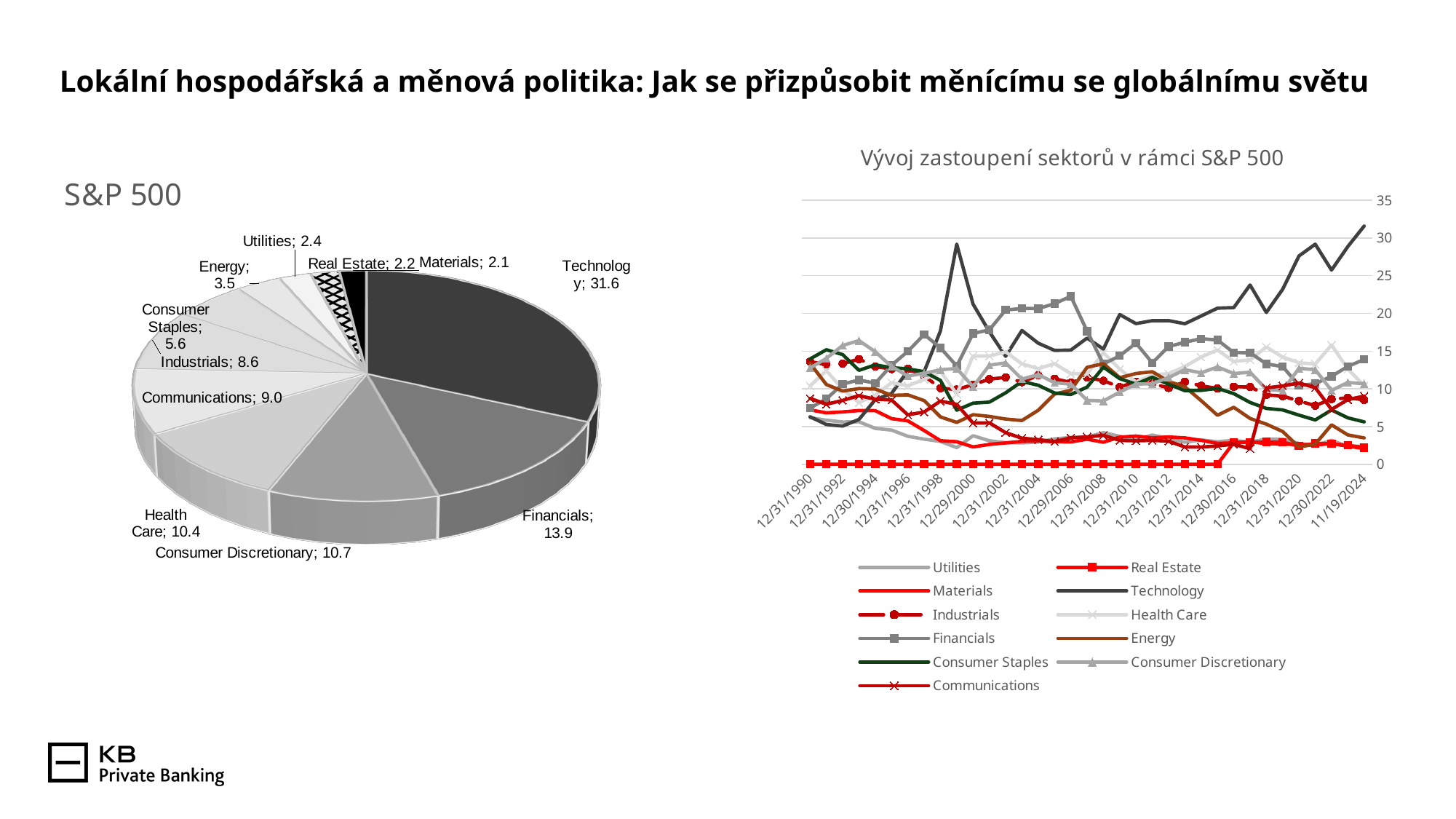
In the S&P 500 pie chart, which sector has the smallest slice? Materials In the chart titled 'Vývoj zastoupení sektorů v rámci S&P 500', is the value for Technology at 11/19/2024 greater or less than 30? greater How many sectors are shown in the S&P 500 pie chart? 11 In the S&P 500 pie chart, what is the value for Technology? 31.6 In the S&P 500 pie chart, what is the difference between the Technology and Financials values? 17.7 What kind of chart is the chart on the left of the slide? Pie chart In the S&P 500 pie chart, what is the value for Financials? 13.9 In the S&P 500 pie chart, what is the value for Consumer Staples? 5.6 In the S&P 500 pie chart, which sector has the largest slice? Technology In the S&P 500 pie chart, which is larger, Health Care or Consumer Discretionary? Consumer Discretionary How many series does the legend of the chart titled 'Vývoj zastoupení sektorů v rámci S&P 500' list? 11 What kind of chart is the chart titled 'Vývoj zastoupení sektorů v rámci S&P 500'? Line chart